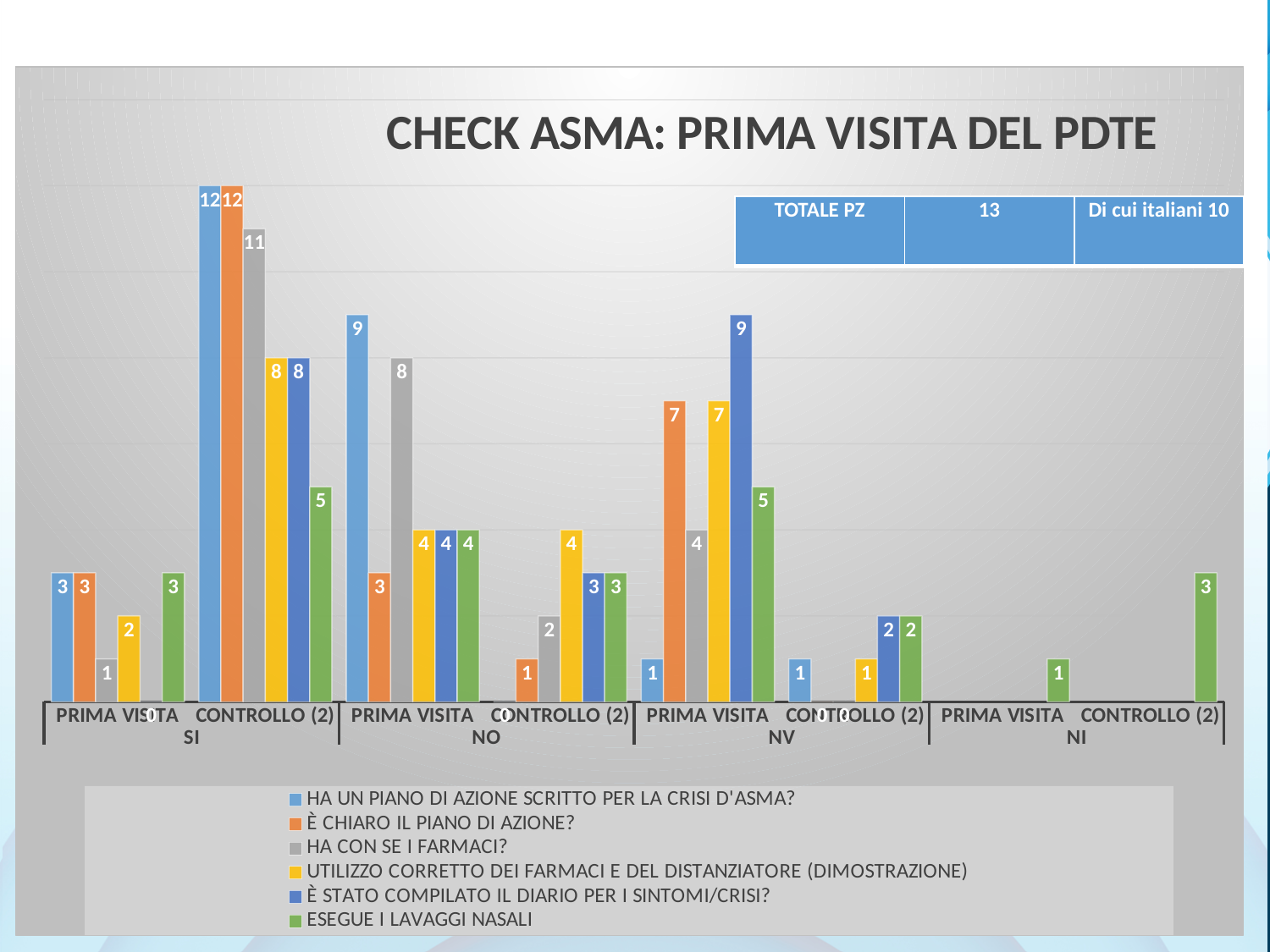
What is the value for 'ESEGUE I LAVAGGI NASALI' at CONTROLLO (2) in the NI group? 3 How many series does the legend list? 6 What is the value for 'È CHIARO IL PIANO DI AZIONE?' at PRIMA VISITA in the NV group? 7 Which series has the lowest value at CONTROLLO (2) in the SI group? ESEGUE I LAVAGGI NASALI How many top-level groups (SI, NO, NV, NI) are shown on the x axis? 4 What is the value for 'È STATO COMPILATO IL DIARIO PER I SINTOMI/CRISI?' at PRIMA VISITA in the NV group? 9 What is the title of the chart? CHECK ASMA: PRIMA VISITA DEL PDTE What is the value for 'HA UN PIANO DI AZIONE SCRITTO PER LA CRISI D'ASMA?' at PRIMA VISITA in the NO group? 9 What is the value for 'HA CON SE I FARMACI?' at CONTROLLO (2) in the SI group? 11 What kind of chart is shown on the slide? bar chart At PRIMA VISITA in the NO group, which is larger: 'HA UN PIANO DI AZIONE SCRITTO PER LA CRISI D'ASMA?' or 'È CHIARO IL PIANO DI AZIONE?'? HA UN PIANO DI AZIONE SCRITTO PER LA CRISI D'ASMA? At CONTROLLO (2) in the SI group, what is the difference between 'HA UN PIANO DI AZIONE SCRITTO PER LA CRISI D'ASMA?' and 'ESEGUE I LAVAGGI NASALI'? 7